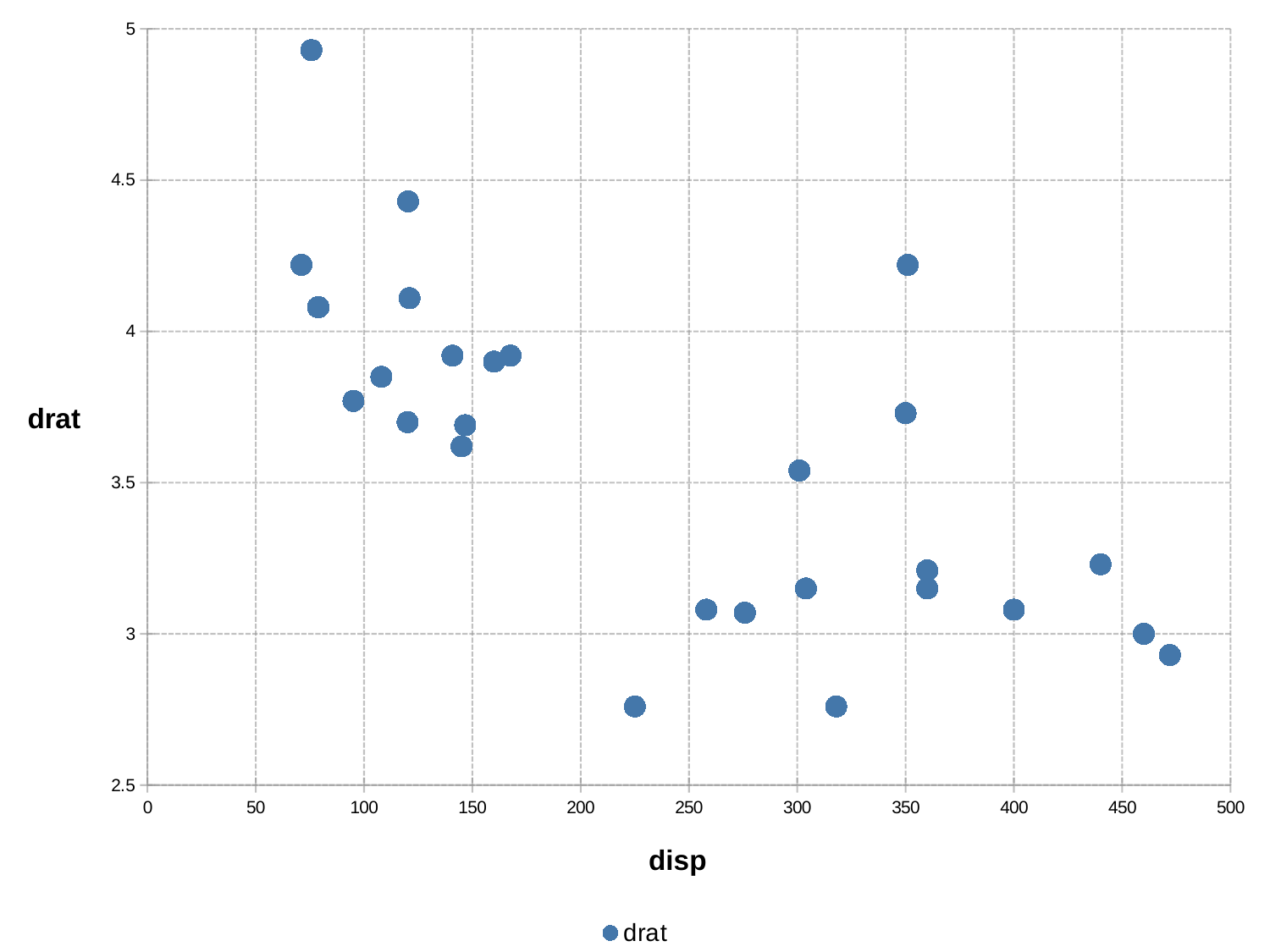
Is the disp value of the point with the largest disp greater or less than 450? greater Is the lowest drat value plotted greater or less than 3? less What is the label on the y axis of the chart? drat Is the highest drat value plotted greater or less than 4.5? greater Overall, do the drat values rise or fall as disp increases along the x axis? Fall Which has the higher drat value: the point at a disp of about 225 or the point at a disp of about 258? The point at about 258 How many series does the legend list? 1 What kind of chart is shown on the slide? Scatter plot Which has the higher drat value: the point at a disp of about 440 or the point at a disp of about 460? The point at about 440 What is the label on the x axis of the chart? disp